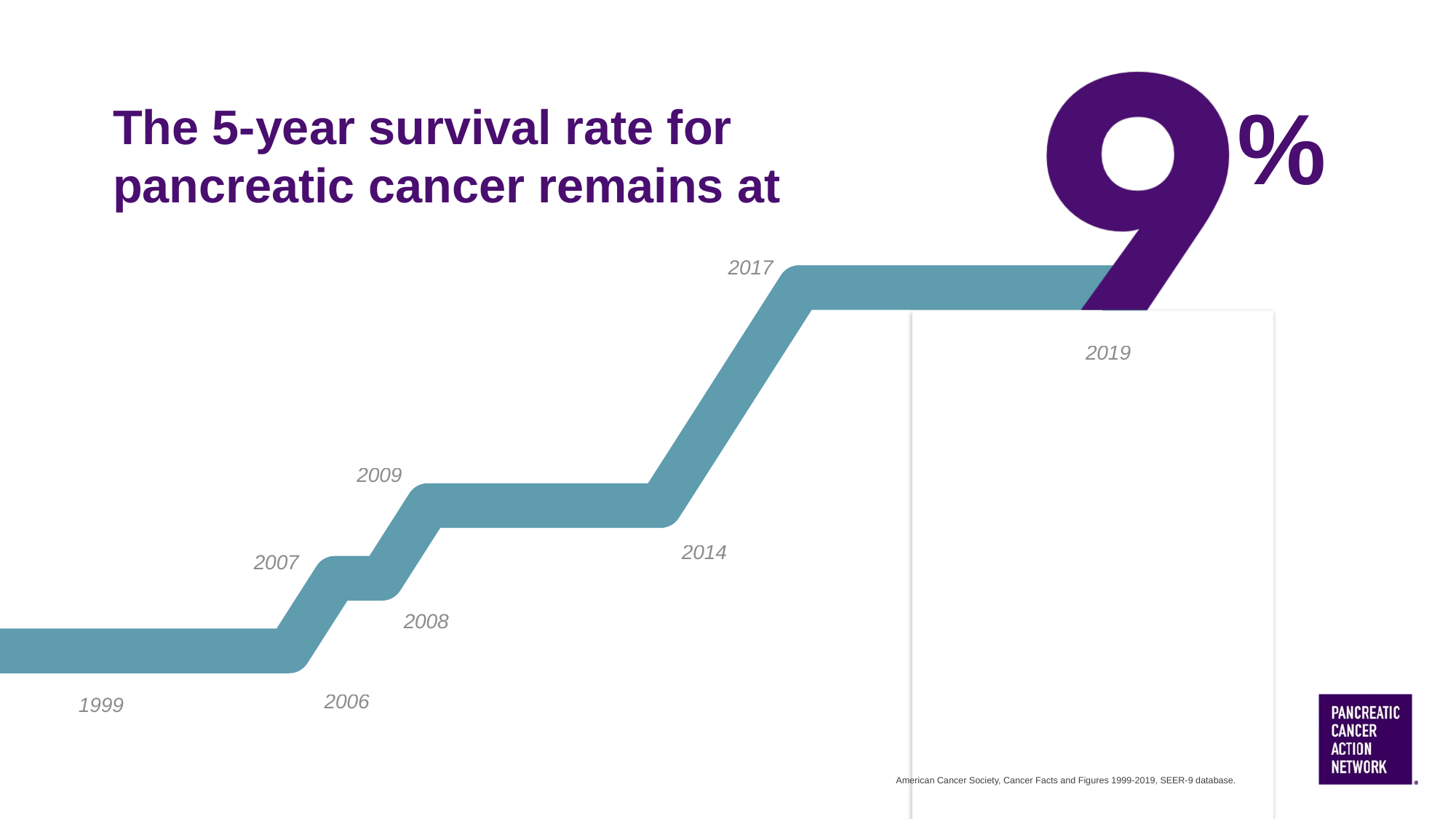
How many year labels are shown along the line? 8 Which year label appears first (leftmost) on the line? 1999 Is the survival rate higher in 2017 or in 2009? 2017 Does the survival rate line rise or fall from 1999 to 2019? rise What is the title text on the slide? The 5-year survival rate for pancreatic cancer remains at 9% What kind of chart is shown on the slide? line chart Is the survival rate higher in 2007 or in 1999? 2007 Is the survival rate higher in 2014 or in 2008? 2014 What is the 5-year survival rate shown for 2019? 9%